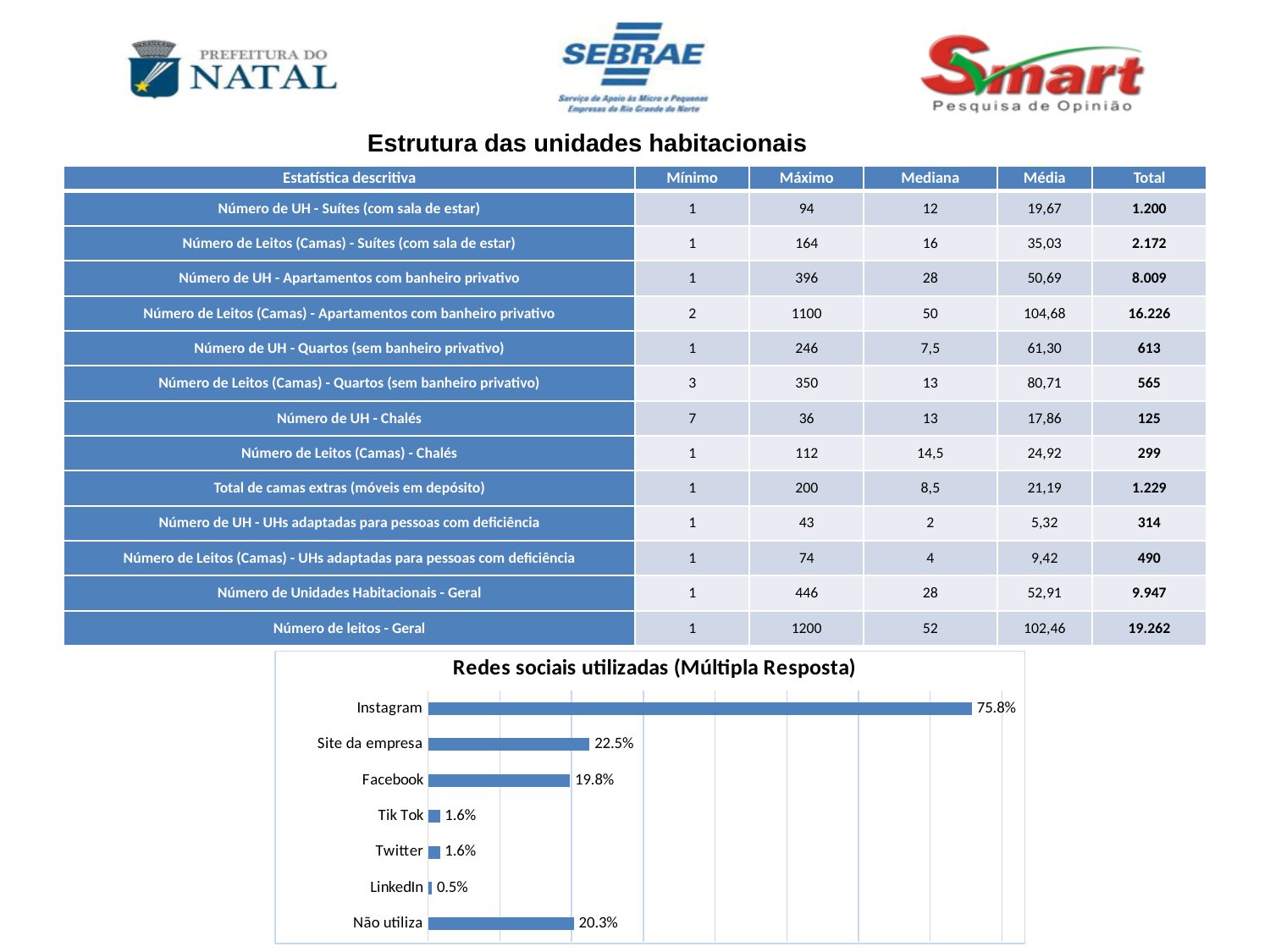
What is the value for Facebook in the chart? 19.8% What is the value for Instagram in the chart? 75.8% What is the difference between the values for Não utiliza and Facebook? 0.5% What is the value for LinkedIn in the chart? 0.5% What is the value for Site da empresa in the chart? 22.5% What type of chart is shown on the slide? Bar chart Which is larger, the value for Site da empresa or the value for Não utiliza? Site da empresa What is the difference between the values for Instagram and Site da empresa? 53.3% Which category has the lowest value in the chart? LinkedIn What is the value for Não utiliza in the chart? 20.3% How many categories are shown in the chart? 7 Which category has the highest value in the chart? Instagram